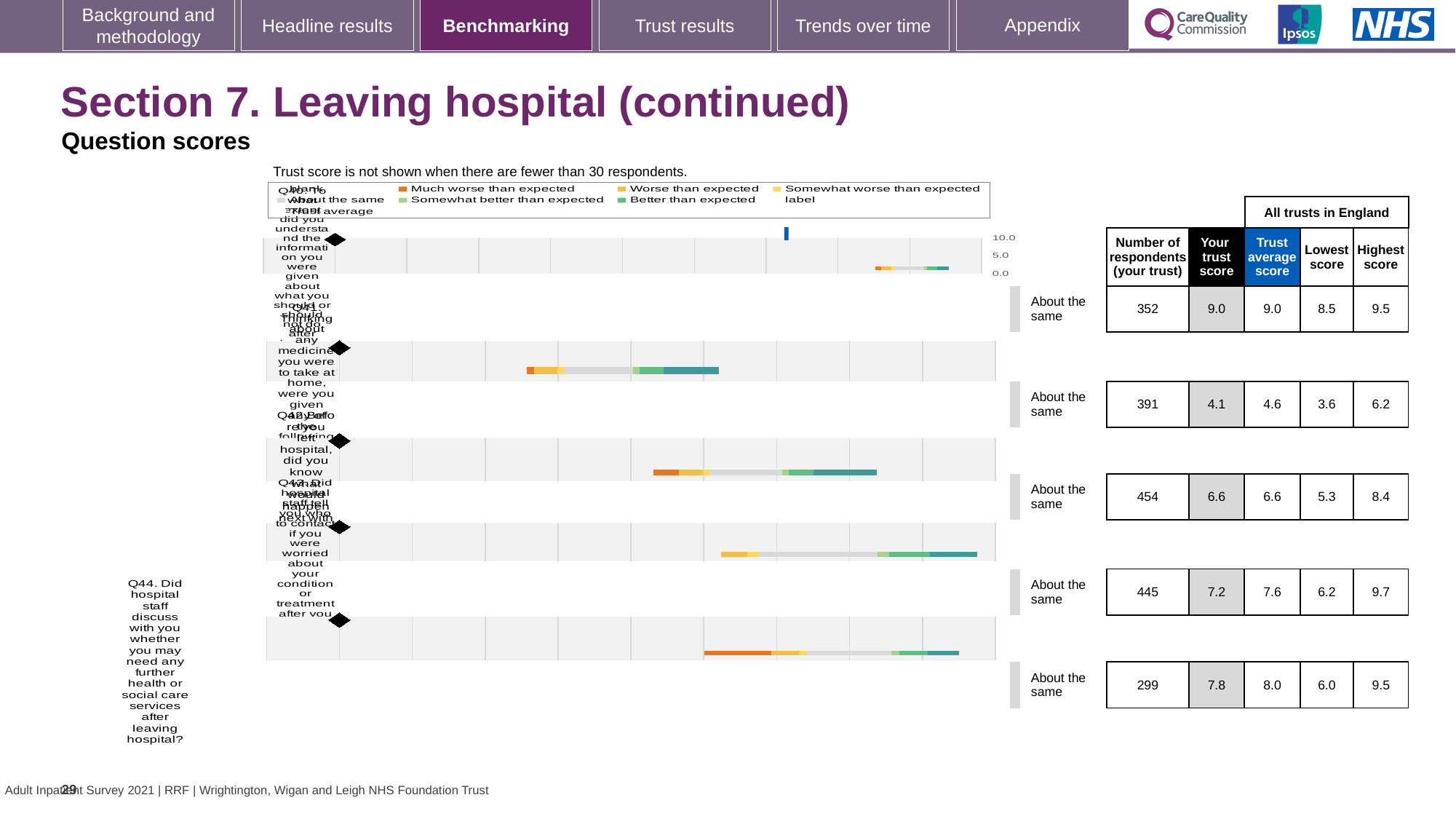
Below how many respondents is the trust score not shown, according to the note above the chart? 30 What is the highest score across all trusts in England for Q44? 9.5 What is the lowest score across all trusts in England for Q44? 6.0 For Q44, which is larger: the trust's own score or the trust average score? Trust average score What is the lowest value in the 'Your trust score' column of the table? 4.1 What is the trust average score for Q44? 8.0 What is the difference between the highest and lowest scores for Q44? 3.5 What is the highest value in the 'Your trust score' column of the table? 9.0 How many questions (rows) are plotted in the benchmarking chart? 5 What is the number of respondents for Q44 (further health or social care services after leaving hospital)? 299 What is the trust's own score for Q44? 7.8 What kind of chart is used to show the question scores on this slide? bar chart